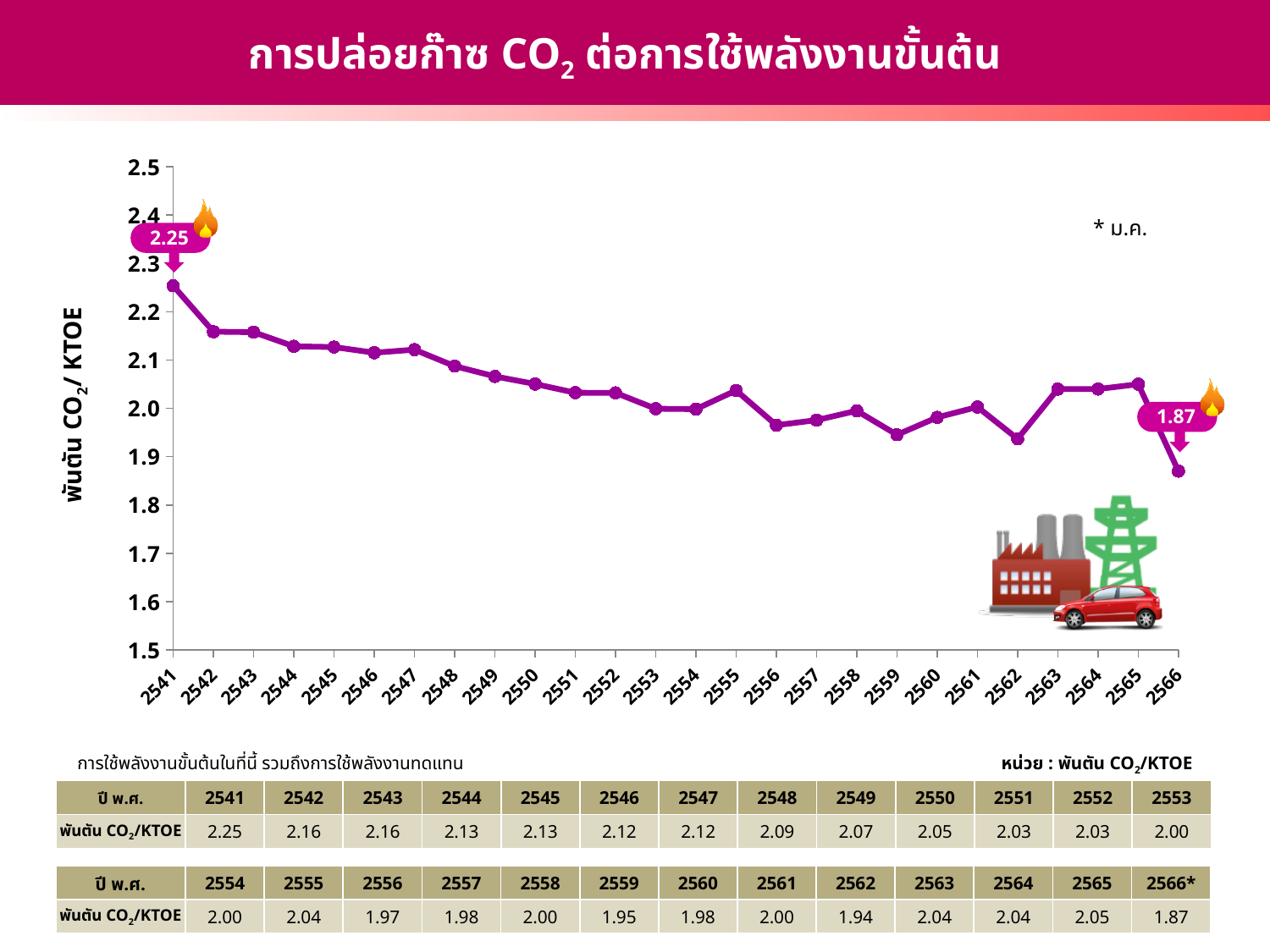
Which year has the highest value? 2541 What is the value for year 2559? 1.95 What is the value for year 2541? 2.25 What kind of chart is shown on the slide? line chart What is the difference between the values for 2562 and 2563? 0.10 What is the difference between the values for 2541 and 2566*? 0.38 Do the values generally rise or fall from 2541 to 2566? fall Is the value for 2541 greater or less than 2.2? greater Which year has the lowest value? 2566* What is the value for year 2566*? 1.87 How many years are plotted on the x axis? 26 Which is larger, the value for 2555 or the value for 2556? 2555